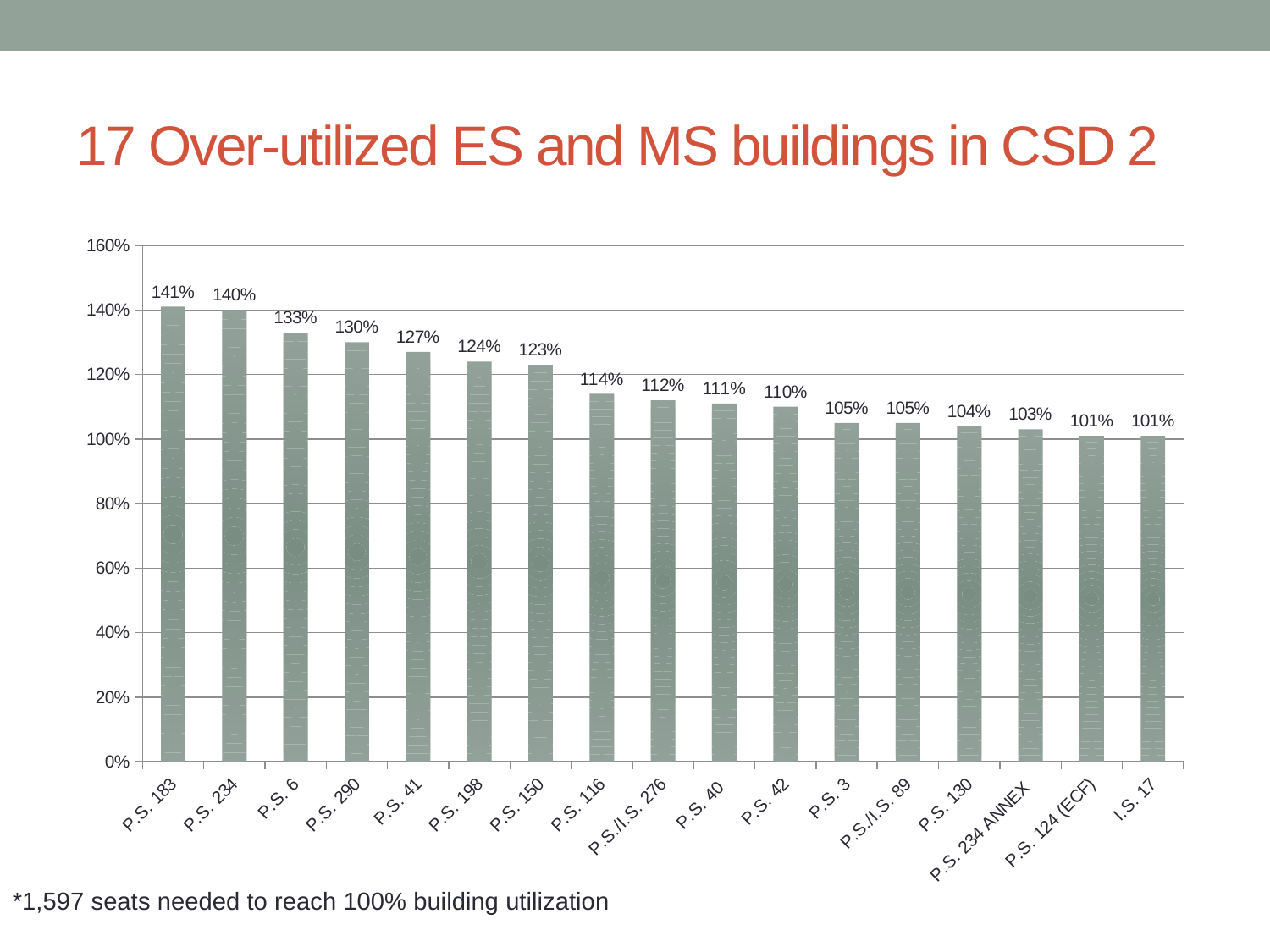
What is the lowest utilization value shown on the chart? 101% Which has a higher utilization value, P.S. 41 or P.S. 42? P.S. 41 What kind of chart is shown on the slide? Bar chart What is the utilization value for P.S. 290? 130% How many buildings are shown on the chart? 17 What is the utilization value for P.S. 234 ANNEX? 103% Do the values rise or fall from left to right along the x axis? Fall Which building has the highest utilization value? P.S. 183 Is the value for P.S. 198 greater or less than 120%? greater What is the utilization value for P.S./I.S. 276? 112% What is the difference between the utilization values of P.S. 6 and P.S. 116? 19% What is the utilization value for P.S. 183? 141%